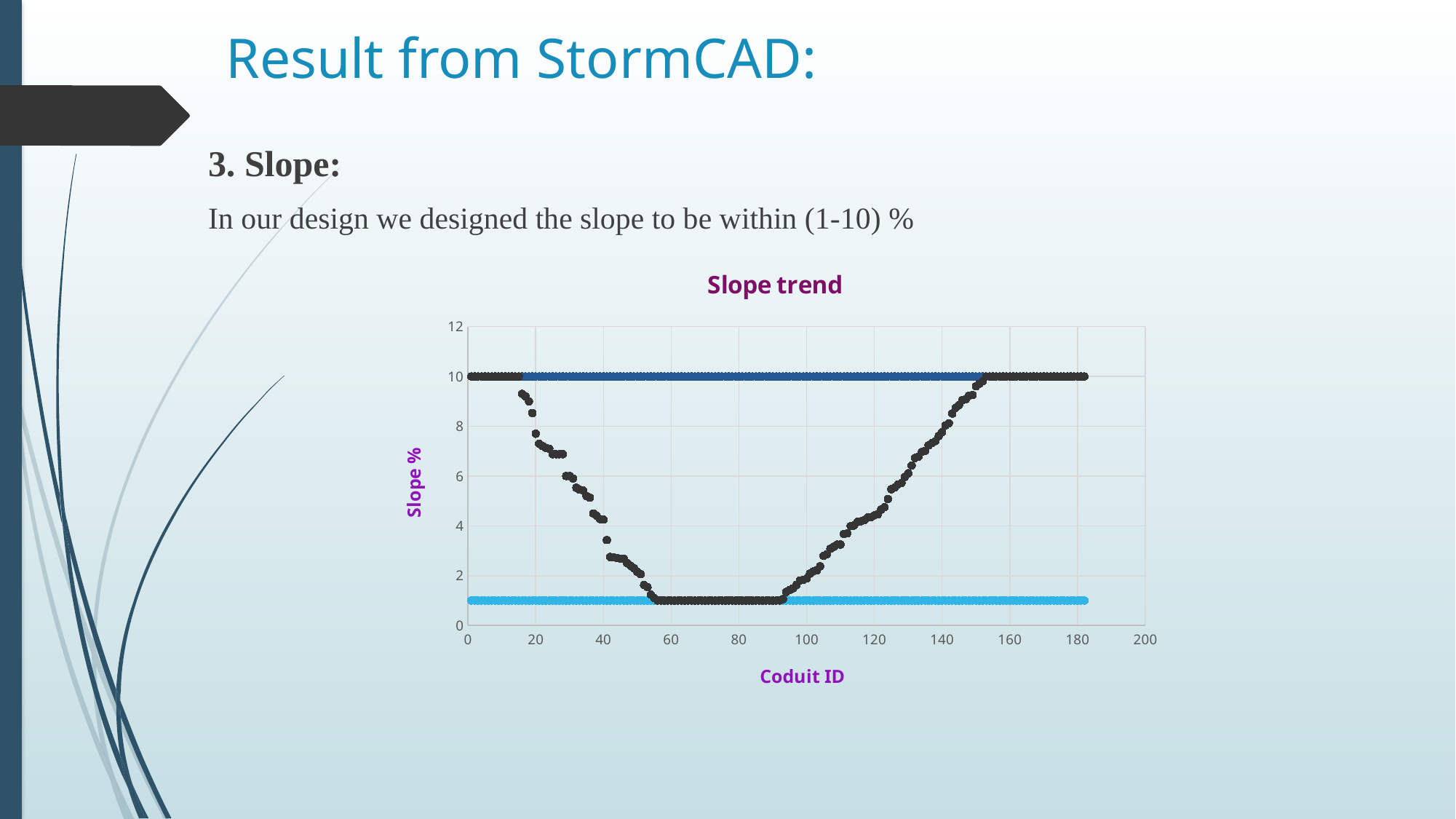
Is the slope value of the black points at Coduit ID 140 greater or less than 6? greater Do the black points rise or fall as Coduit ID increases from 100 to 150? rise Is the slope value of the black points at Coduit ID 100 greater or less than 4? less What is the title of the chart? Slope trend What kind of chart is shown on the slide? scatter chart Do the black points rise or fall as Coduit ID increases from 20 to 60? fall What is the label of the x axis of the chart? Coduit ID Is the slope value of the black points at Coduit ID 80 greater or less than 2? less